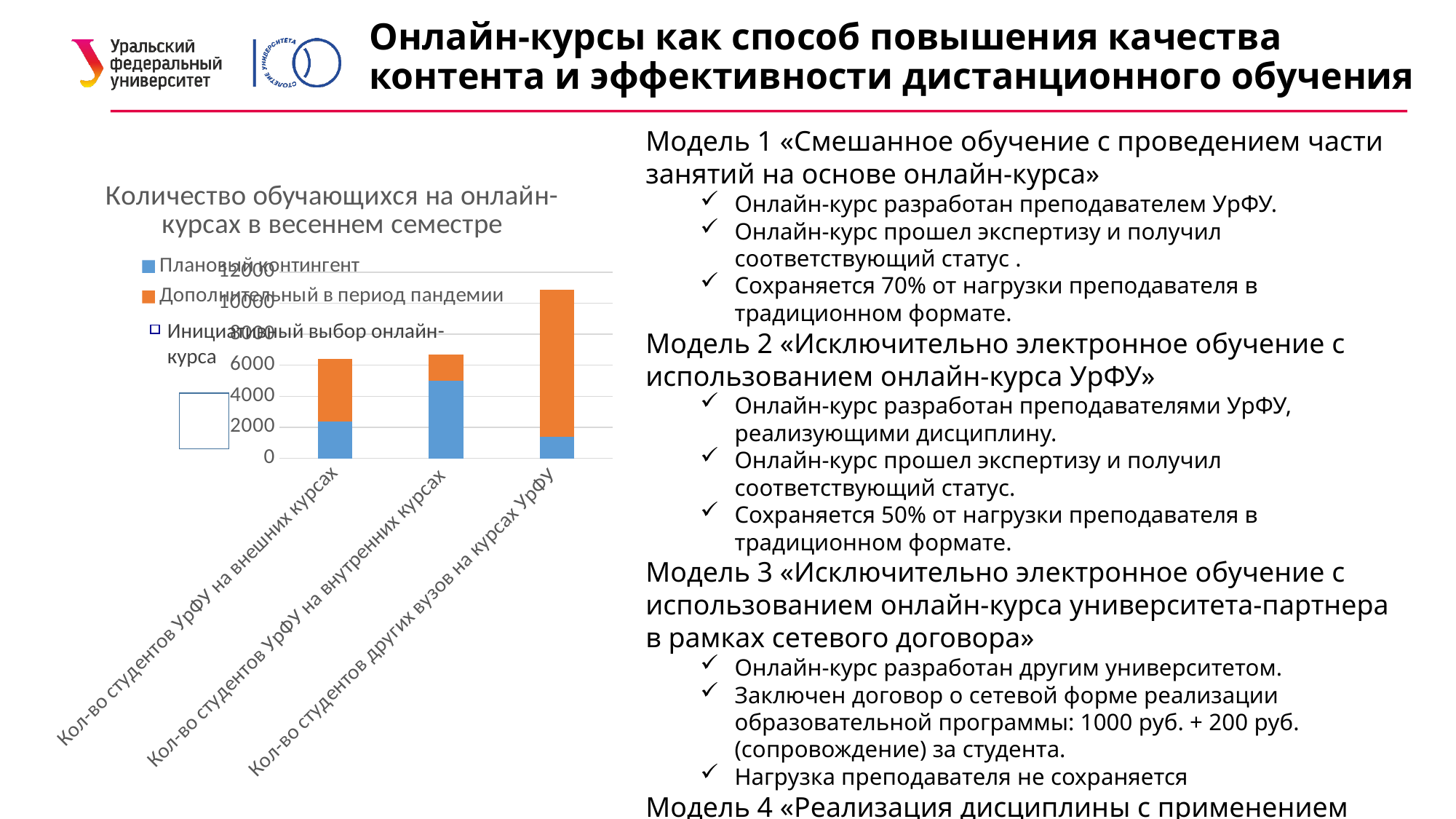
Which category has the tallest stacked bar? Кол-во студентов других вузов на курсах УрФУ Which is larger: the Дополнительный в период пандемии value for Кол-во студентов других вузов на курсах УрФУ or for Кол-во студентов УрФУ на внутренних курсах? Кол-во студентов других вузов на курсах УрФУ How many series does the chart legend list? 2 What kind of chart is shown on the slide? bar chart Is the total stacked value for Кол-во студентов других вузов на курсах УрФУ greater or less than 10000? greater Is the Плановый контингент value for Кол-во студентов УрФУ на внешних курсах greater or less than 4000? less How many categories are shown on the x axis of the chart? 3 Is the total stacked value for Кол-во студентов УрФУ на внутренних курсах greater or less than 8000? less What is the title of the chart? Количество обучающихся на онлайн-курсах в весеннем семестре Which category has the largest Плановый контингент value? Кол-во студентов УрФУ на внутренних курсах Which colour represents the series Дополнительный в период пандемии in the chart? orange Which category has the smallest Плановый контингент value? Кол-во студентов других вузов на курсах УрФУ